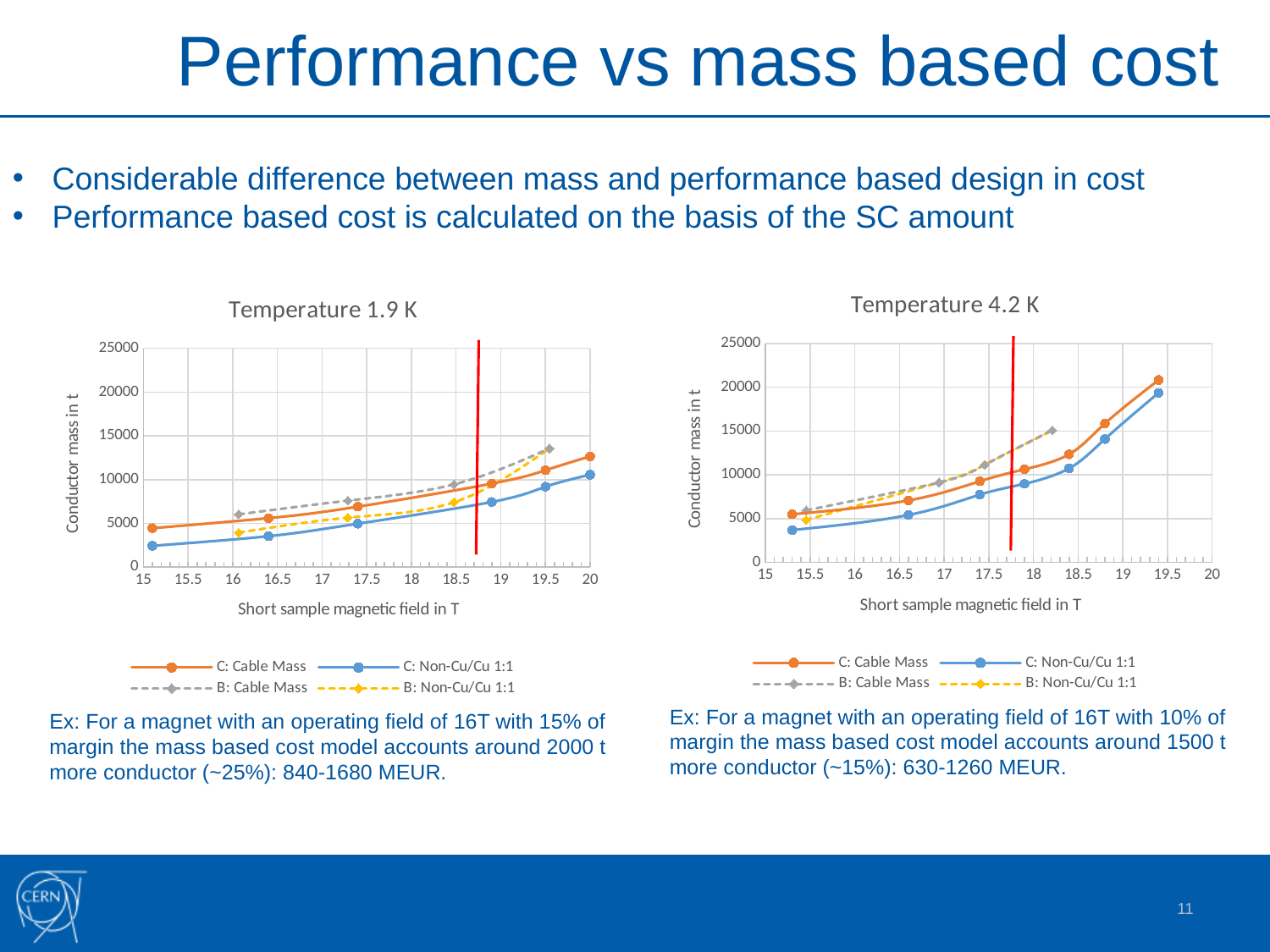
How many series does the legend of the "Temperature 4.2 K" chart list? 4 In the "Temperature 4.2 K" chart, which series has the larger conductor mass at around 17.5 T: C: Cable Mass or C: Non-Cu/Cu 1:1? C: Cable Mass In the "Temperature 4.2 K" chart, is the value for C: Cable Mass at its highest field point (around 19.5 T) greater or less than 15000? greater What kind of chart is the "Temperature 1.9 K" chart? line chart In the "Temperature 1.9 K" chart, which series has the larger conductor mass at 20 T: C: Cable Mass or C: Non-Cu/Cu 1:1? C: Cable Mass In the "Temperature 4.2 K" chart, does the conductor mass for C: Non-Cu/Cu 1:1 rise or fall as the short sample magnetic field increases? rise In the "Temperature 4.2 K" chart, is the value for C: Non-Cu/Cu 1:1 at its highest field point (around 19.5 T) greater or less than 20000? less In the "Temperature 1.9 K" chart, is the value for C: Non-Cu/Cu 1:1 at its lowest field point (around 15 T) greater or less than 5000? less What is the y-axis label of the "Temperature 4.2 K" chart? Conductor mass in t What is the title of the chart on the left side of the slide? Temperature 1.9 K In the "Temperature 1.9 K" chart, does the conductor mass for C: Cable Mass rise or fall as the short sample magnetic field increases? rise